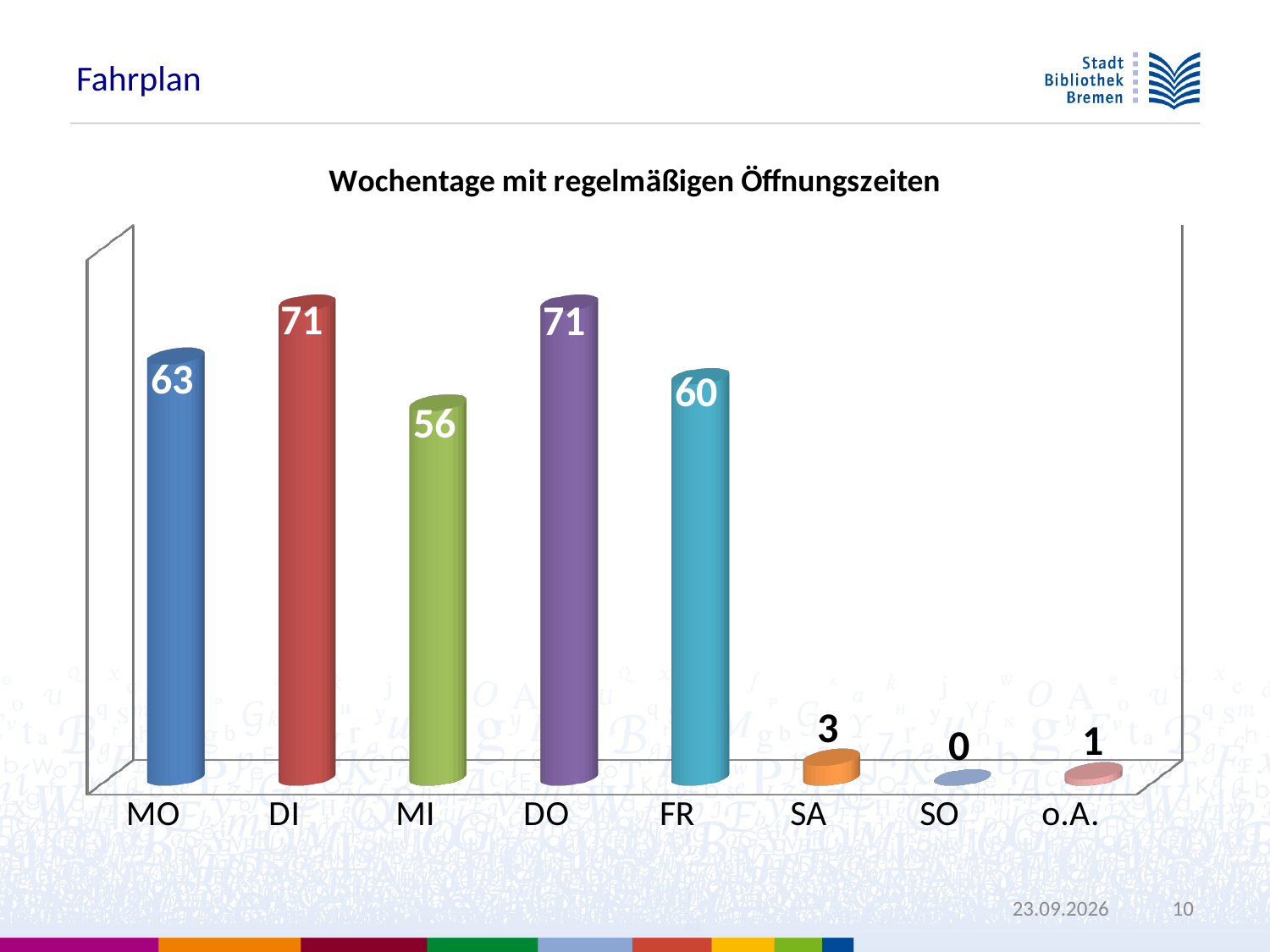
Which category has the lowest value? SO What is the title of the chart? Wochentage mit regelmäßigen Öffnungszeiten What is the value for MI? 56 How many categories are shown on the x axis? 8 What kind of chart is shown? bar chart What is the value for FR? 60 What is the value for SO? 0 What is the difference between the values for MO and FR? 3 What is the value for MO? 63 What is the difference between the values for DI and MI? 15 Which is larger, the value for MO or the value for MI? MO What is the value for SA? 3